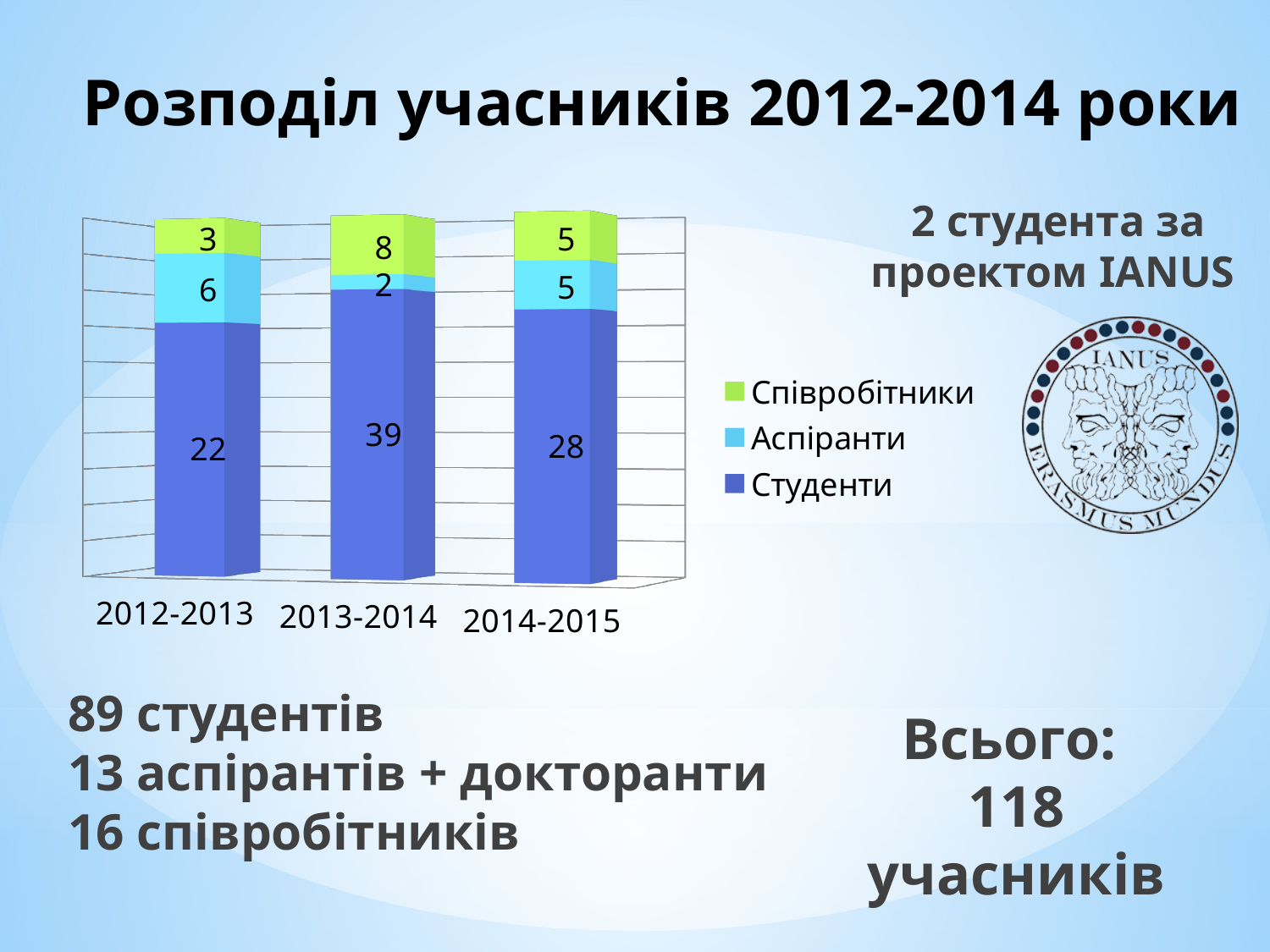
What is the total of the stacked bar for 2014-2015? 38 How many categories (academic years) are shown on the x axis of the chart? 3 What is the difference between the Студенти values for 2013-2014 and 2012-2013? 17 How many series does the chart legend list? 3 Which series is shown in green in the chart legend? Співробітники What type of chart is shown on the slide? Stacked bar chart What is the value for Студенти in 2013-2014? 39 In which academic year is the value for Студенти the highest? 2013-2014 What is the value for Аспіранти in 2012-2013? 6 What is the value for Співробітники in 2014-2015? 5 In which academic year is the value for Аспіранти the lowest? 2013-2014 Which is larger: the Співробітники value for 2013-2014 or for 2012-2013? 2013-2014